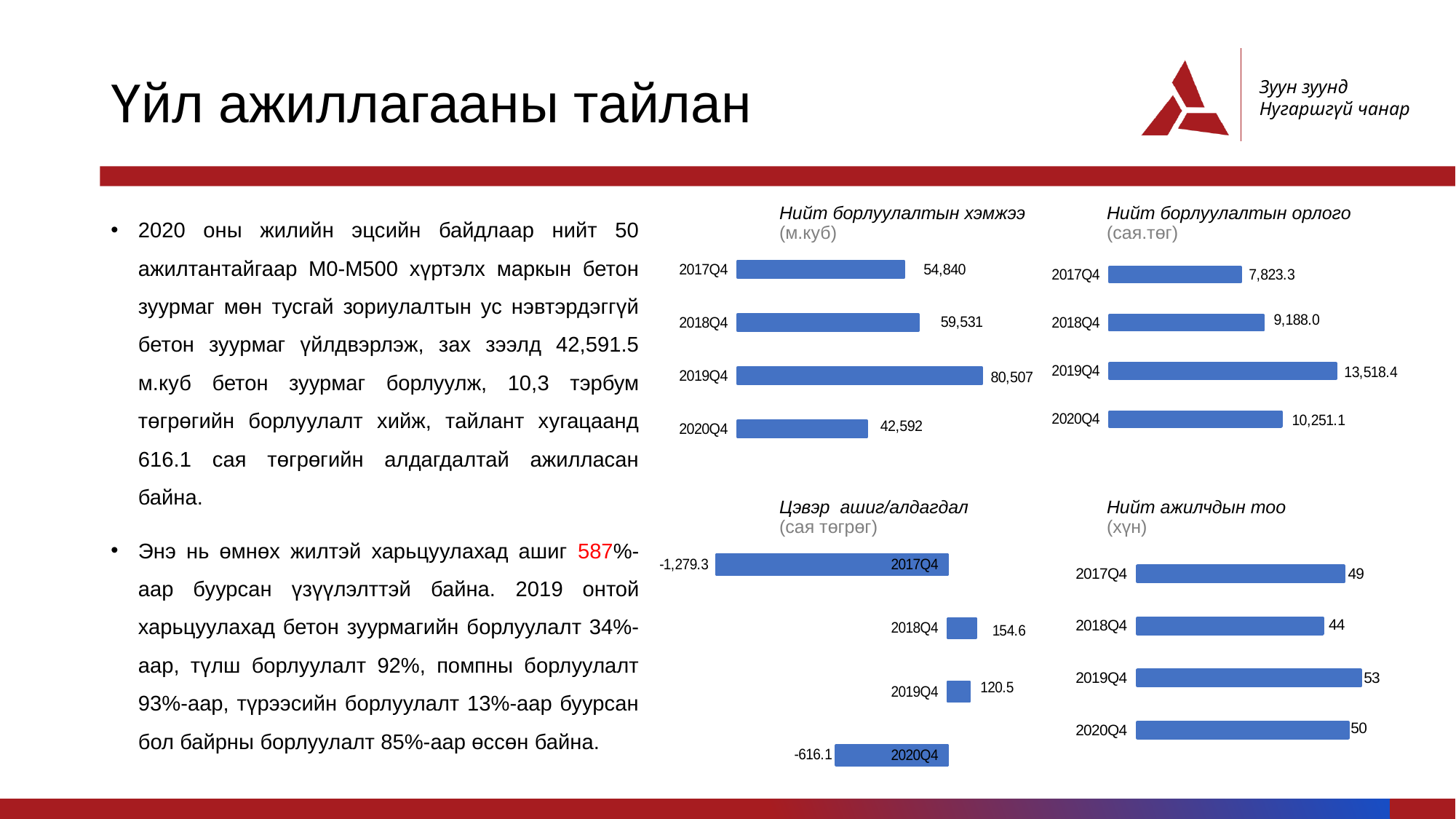
In the chart titled 'Цэвэр ашиг/алдагдал', what is the value for 2017Q4? -1,279.3 In the chart titled 'Нийт борлуулалтын хэмжээ', what is the value for 2019Q4? 80,507 In the chart titled 'Нийт борлуулалтын орлого', what is the value for 2020Q4? 10,251.1 In the chart titled 'Цэвэр ашиг/алдагдал', what is the value for 2020Q4? -616.1 How many charts are shown on the slide, and what type are they? 4 bar charts In the chart titled 'Нийт борлуулалтын орлого', which period has the highest value? 2019Q4 In the chart titled 'Нийт борлуулалтын хэмжээ', what is the difference between the 2019Q4 and 2020Q4 values? 37,915 In the chart titled 'Нийт борлуулалтын орлого', which is larger, the value for 2018Q4 or 2020Q4? 2020Q4 In the chart titled 'Нийт ажилчдын тоо', what is the difference between the 2019Q4 and 2018Q4 values? 9 In the chart titled 'Цэвэр ашиг/алдагдал', which period has the highest value? 2018Q4 In the chart titled 'Нийт борлуулалтын хэмжээ', which period has the lowest value? 2020Q4 In the chart titled 'Нийт ажилчдын тоо', what is the value for 2018Q4? 44